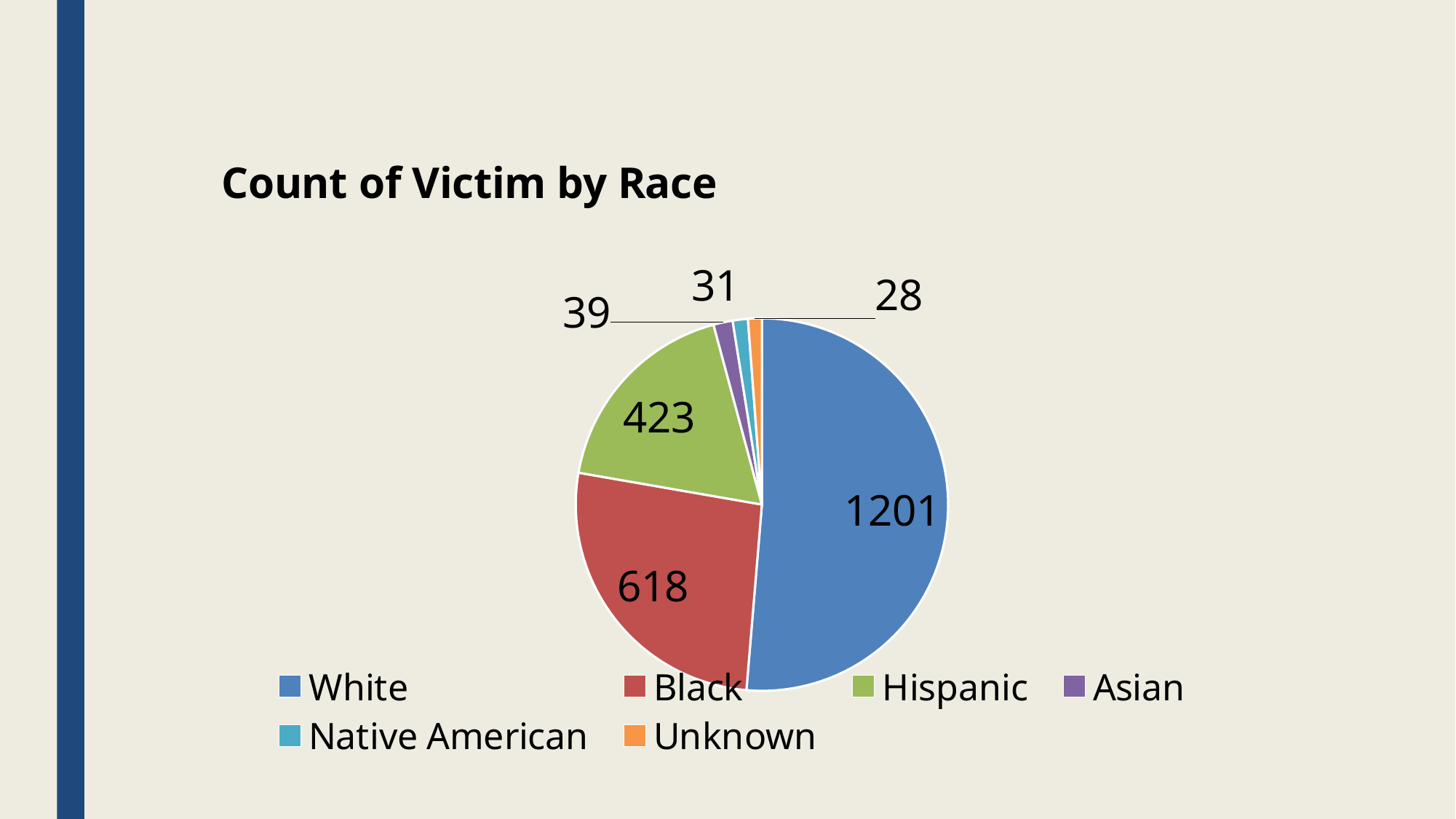
What is the count of victims for Hispanic? 423 What is the count of victims for Unknown? 28 What is the count of victims for Asian? 39 What is the count of victims for White? 1201 What kind of chart is shown on the slide? Pie chart What is the count of victims for Black? 618 Which race has the lowest count of victims? Unknown Which race has the highest count of victims? White What is the difference between the counts for White and Black? 583 How many race categories are shown in the pie chart? 6 Which is larger, the count for Hispanic or the count for Black? Black What is the title of the chart? Count of Victim by Race